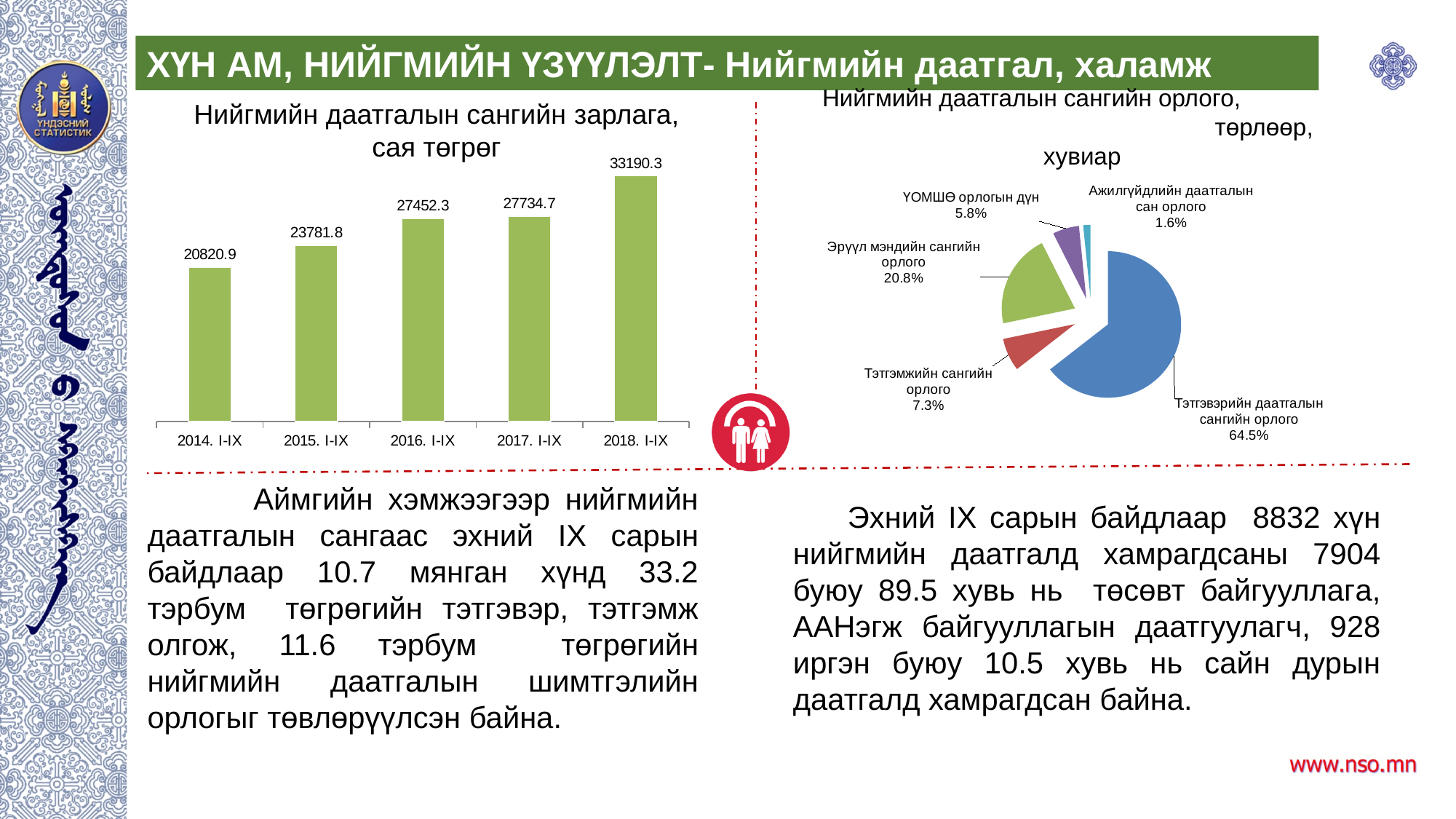
In the pie chart 'Нийгмийн даатгалын сангийн орлого, төрлөөр, хувиар', how many slices are there? 5 In the bar chart 'Нийгмийн даатгалын сангийн зарлага, сая төгрөг', what is the difference between the values for 2018. I-IX and 2017. I-IX? 5455.6 In the bar chart 'Нийгмийн даатгалын сангийн зарлага, сая төгрөг', how many bars are shown? 5 In the pie chart 'Нийгмийн даатгалын сангийн орлого, төрлөөр, хувиар', which category has the smallest share? Ажилгүйдлийн даатгалын сан орлого In the bar chart 'Нийгмийн даатгалын сангийн зарлага, сая төгрөг', do the values rise or fall from 2014. I-IX to 2018. I-IX? rise In the pie chart 'Нийгмийн даатгалын сангийн орлого, төрлөөр, хувиар', what share does 'Эрүүл мэндийн сангийн орлого' have? 20.8% In the bar chart 'Нийгмийн даатгалын сангийн зарлага, сая төгрөг', which period has the lowest value? 2014. I-IX In the pie chart 'Нийгмийн даатгалын сангийн орлого, төрлөөр, хувиар', what share does 'Тэтгэврийн даатгалын сангийн орлого' have? 64.5% In the bar chart 'Нийгмийн даатгалын сангийн зарлага, сая төгрөг', which period has the highest value? 2018. I-IX What kind of chart is the chart on the left of the slide? bar chart In the bar chart 'Нийгмийн даатгалын сангийн зарлага, сая төгрөг', what is the value for 2014. I-IX? 20820.9 In the bar chart 'Нийгмийн даатгалын сангийн зарлага, сая төгрөг', what is the value for 2017. I-IX? 27734.7